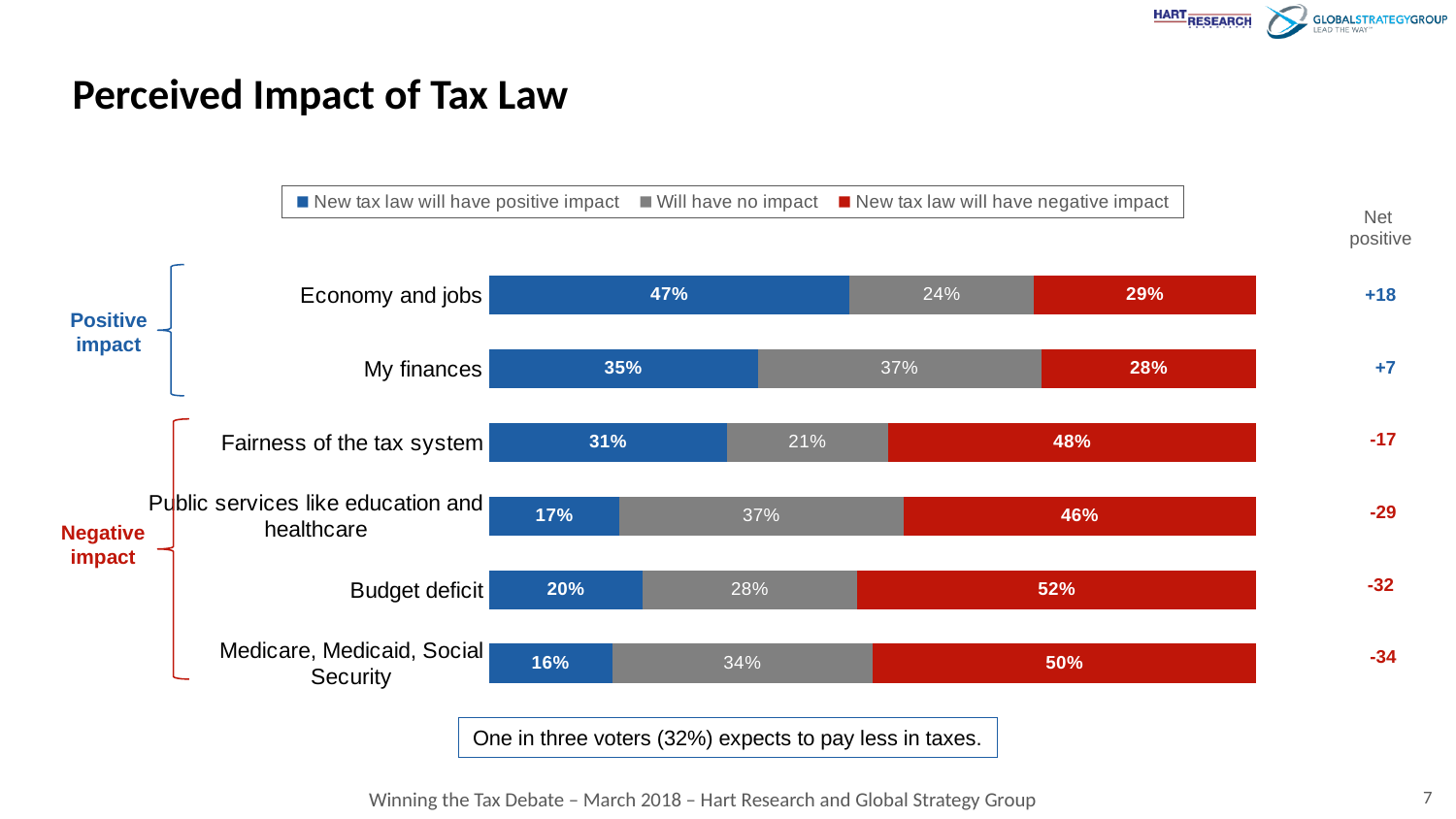
What is the title of the chart on the slide? Perceived Impact of Tax Law Which is larger: the negative-impact share for budget deficit or the negative-impact share for Medicare, Medicaid, Social Security? Budget deficit Which category has the lowest share saying the new tax law will have a positive impact? Medicare, Medicaid, Social Security What is the net positive value shown for public services like education and healthcare? -29 What percentage of voters say the new tax law will have a negative impact on the budget deficit? 52% What kind of chart is shown on the slide? Stacked bar chart How many categories are shown in the chart? 6 Which category has the highest share saying the new tax law will have a positive impact? Economy and jobs How many series does the legend list? 3 What percentage of voters say the new tax law will have a positive impact on the economy and jobs? 47% What percentage of voters say the new tax law will have no impact on my finances? 37% What is the difference between the negative-impact share for fairness of the tax system and the positive-impact share for fairness of the tax system? 17 percentage points